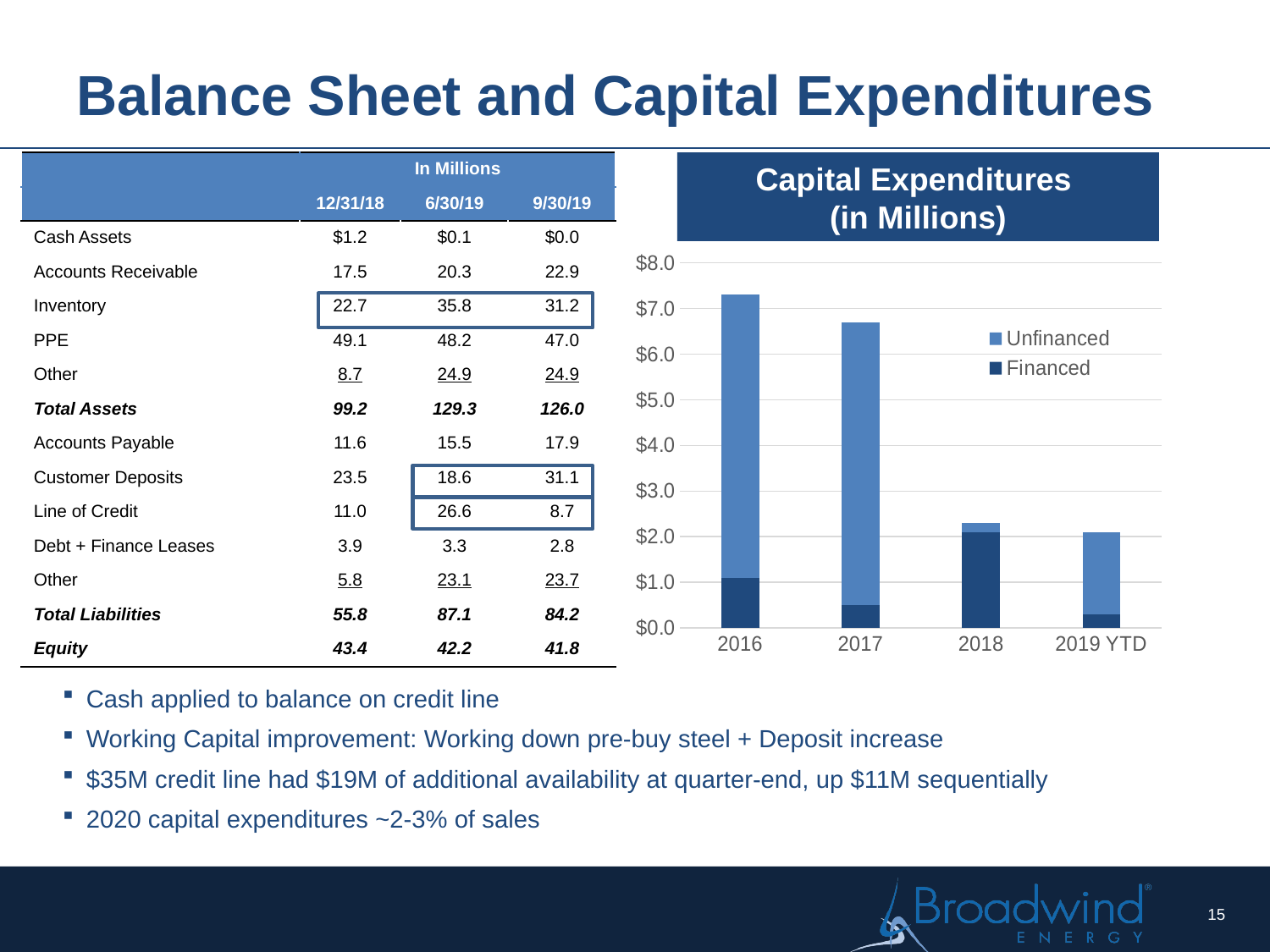
What are the two legend entries in the Capital Expenditures chart? Unfinanced and Financed How many series does the legend of the Capital Expenditures chart list? 2 What kind of chart is the Capital Expenditures chart? Stacked bar chart Is the total capital expenditure for 2018 greater or less than $3.0? less Do total capital expenditures rise or fall from 2016 to 2019 YTD? fall Which year has the largest Financed portion in the Capital Expenditures chart? 2018 How many years (categories) are shown on the x axis of the Capital Expenditures chart? 4 Which year has the highest total capital expenditures in the chart? 2016 Is the total capital expenditure for 2016 greater or less than $7.0? greater Which is larger, total capital expenditures in 2016 or in 2017? 2016 Is the Financed portion for 2017 greater or less than $1.0? less